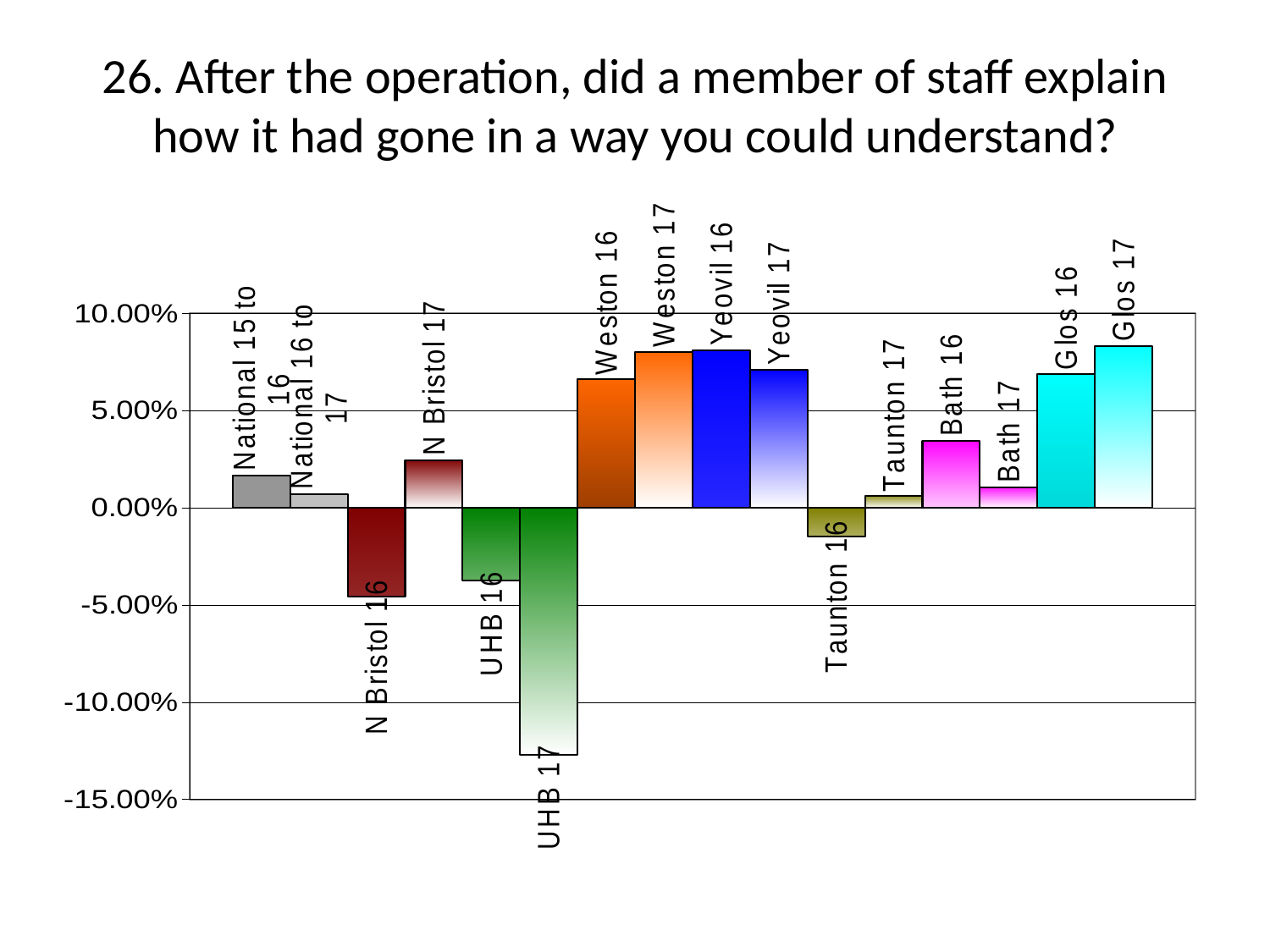
What kind of chart is shown on the slide? bar chart Which is larger, the value for UHB 16 or the value for UHB 17? UHB 16 Which is larger, the value for Weston 16 or the value for Bath 16? Weston 16 Is the value for UHB 17 greater or less than -10.00%? less Is the value for Glos 16 greater or less than 5.00%? greater How many bars are plotted in the chart? 16 Is the value for N Bristol 16 greater or less than 0.00%? less Which category has the lowest value in the chart? UHB 17 What is the title of the chart on the slide? 26. After the operation, did a member of staff explain how it had gone in a way you could understand?